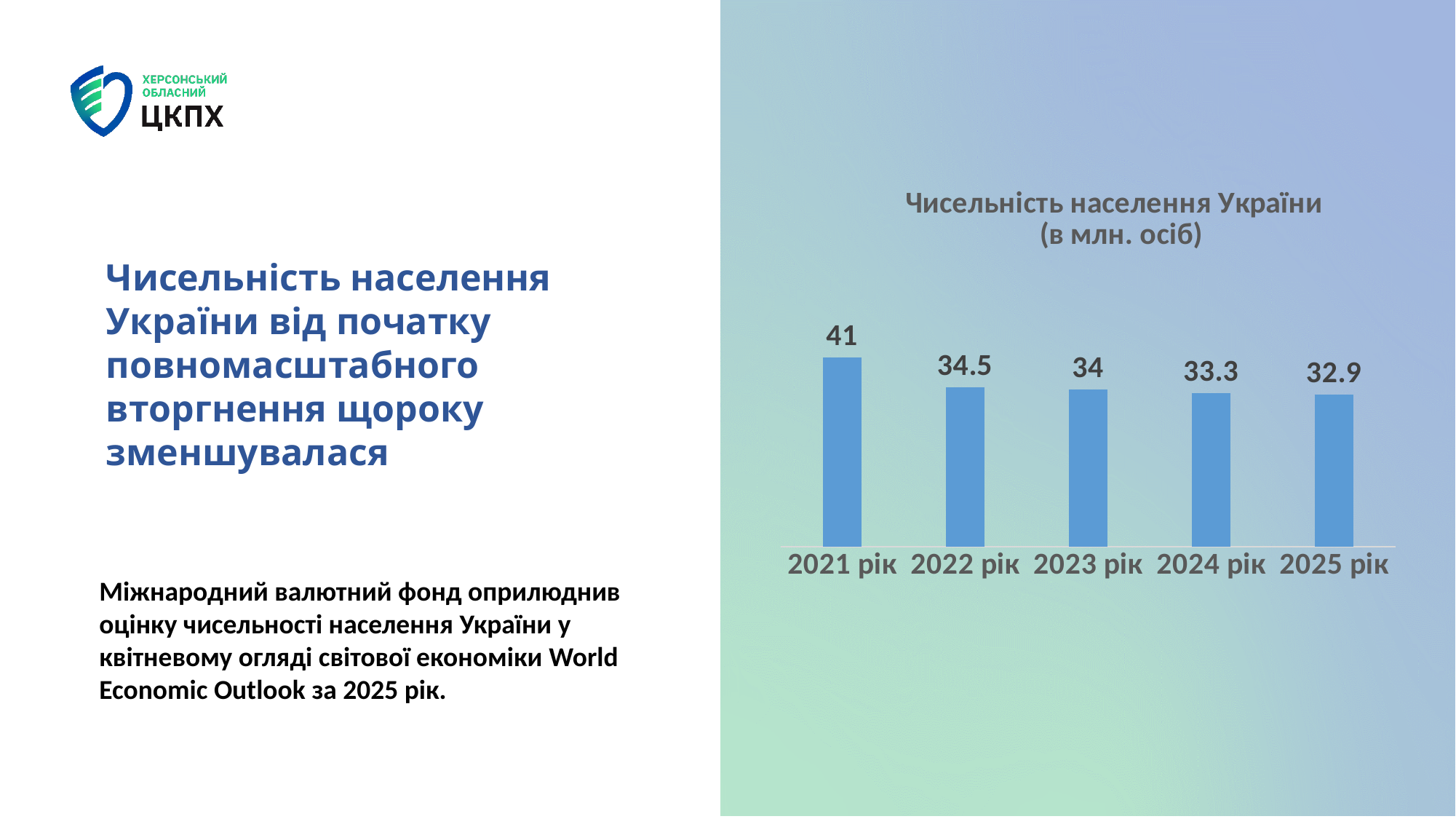
What is the population value shown for 2025 рік? 32.9 Do the values rise or fall from 2021 рік to 2025 рік? Fall What kind of chart is shown on the slide? Bar chart What is the difference between the values for 2024 рік and 2025 рік? 0.4 What is the difference between the values for 2021 рік and 2022 рік? 6.5 How many years are shown on the chart? 5 Which year has the lowest population value? 2025 рік What is the population value shown for 2023 рік? 34 What is the population value shown for 2021 рік? 41 Which year has the highest population value? 2021 рік What is the title of the chart? Чисельність населення України (в млн. осіб) Which is larger, the value for 2022 рік or the value for 2024 рік? 2022 рік